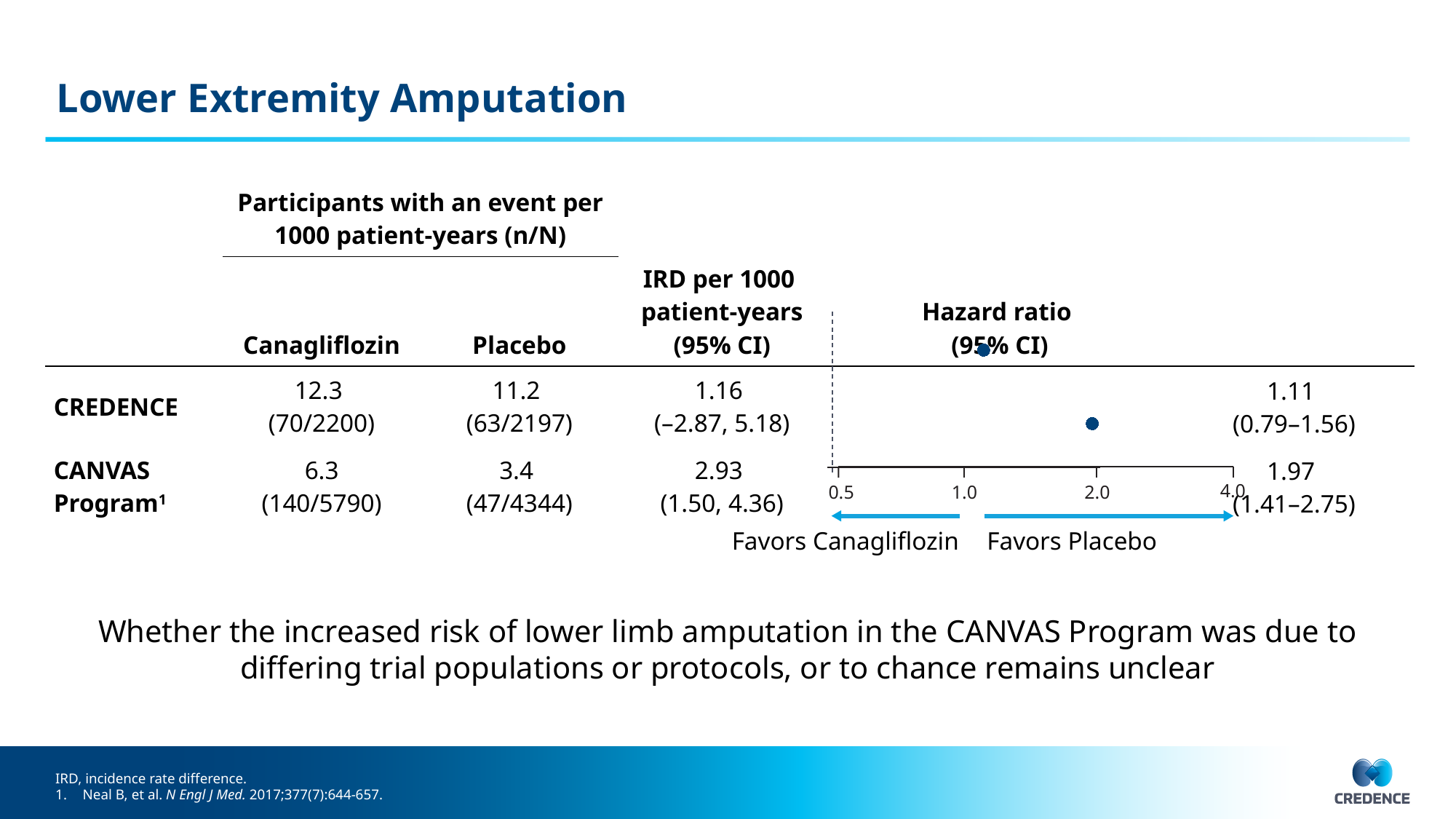
What is the rate of participants with an event per 1000 patient-years for canagliflozin in CREDENCE? 12.3 How many studies are plotted in the hazard ratio chart? 2 What does the left arrow below the hazard ratio axis indicate? Favors Canagliflozin What kind of chart is used to display the hazard ratios? Forest plot Which study has the higher hazard ratio for lower extremity amputation, CREDENCE or the CANVAS Program? CANVAS Program What are the tick values shown on the hazard ratio axis? 0.5, 1.0, 2.0, 4.0 What is the difference between the CANVAS Program hazard ratio and the CREDENCE hazard ratio? 0.86 What is the rate of participants with an event per 1000 patient-years for placebo in the CANVAS Program? 3.4 What is the hazard ratio (95% CI) for CREDENCE in the Lower Extremity Amputation chart? 1.11 (0.79–1.56) What is the hazard ratio (95% CI) for the CANVAS Program in the Lower Extremity Amputation chart? 1.97 (1.41–2.75) What is the IRD per 1000 patient-years (95% CI) for the CANVAS Program? 2.93 (1.50, 4.36) Is the hazard ratio for the CANVAS Program greater or less than 1.0? greater